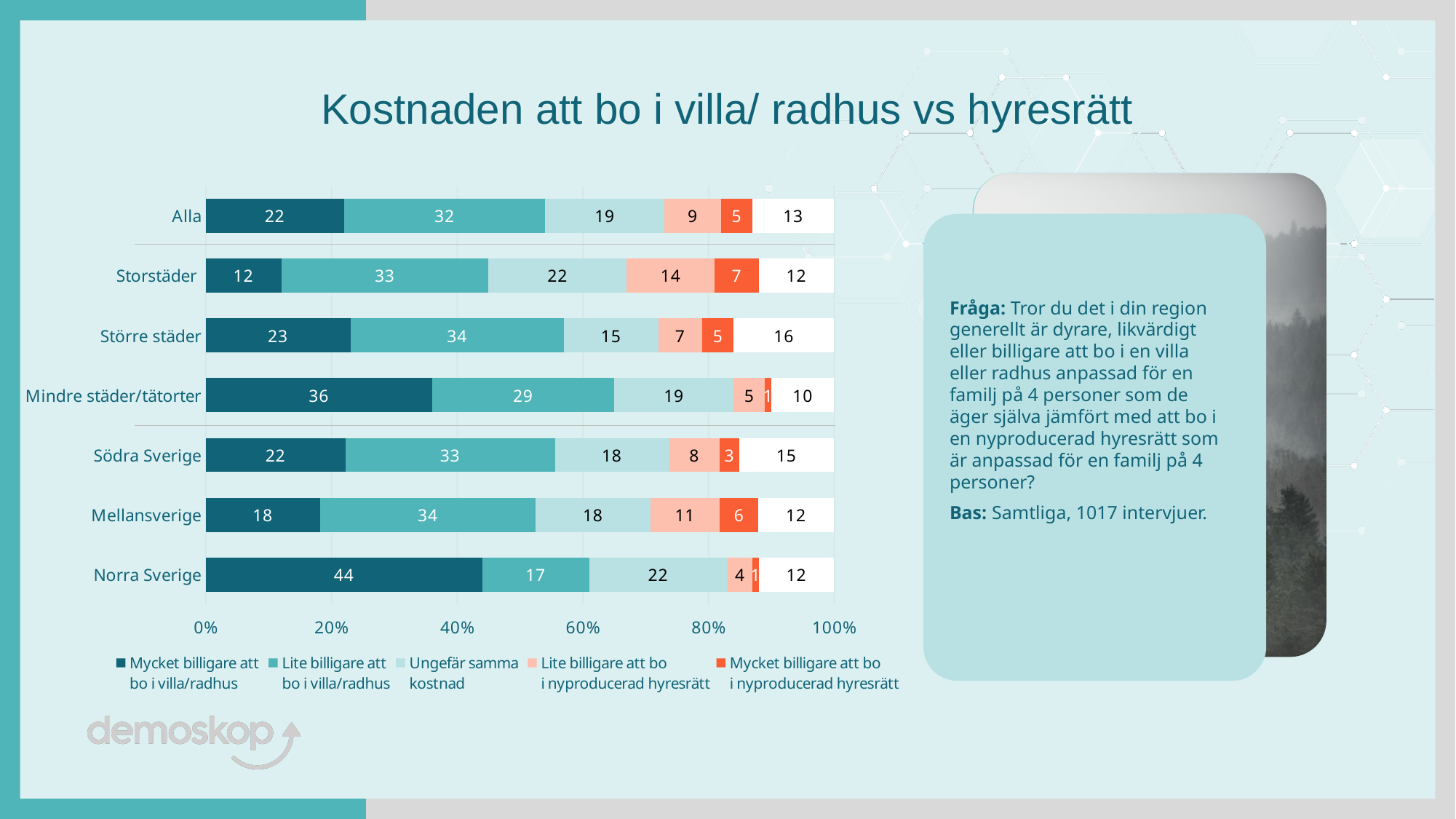
Which category has the lowest value for 'Mycket billigare att bo i villa/radhus'? Storstäder How many series does the legend list? 5 Which category has the highest value for 'Lite billigare att bo i nyproducerad hyresrätt'? Storstäder What is the difference between the 'Mycket billigare att bo i villa/radhus' values for Mindre städer/tätorter and Alla? 14 What is the title of the chart? Kostnaden att bo i villa/ radhus vs hyresrätt What is the value for 'Mycket billigare att bo i nyproducerad hyresrätt' for Storstäder? 7 Which has the larger value for 'Lite billigare att bo i villa/radhus': Större städer or Norra Sverige? Större städer Which category has the highest value for 'Mycket billigare att bo i villa/radhus'? Norra Sverige What kind of chart is shown on the slide? Stacked bar chart How many categories are shown on the chart? 7 What is the value for 'Ungefär samma kostnad' for Storstäder? 22 What is the value for 'Mycket billigare att bo i villa/radhus' for Norra Sverige? 44